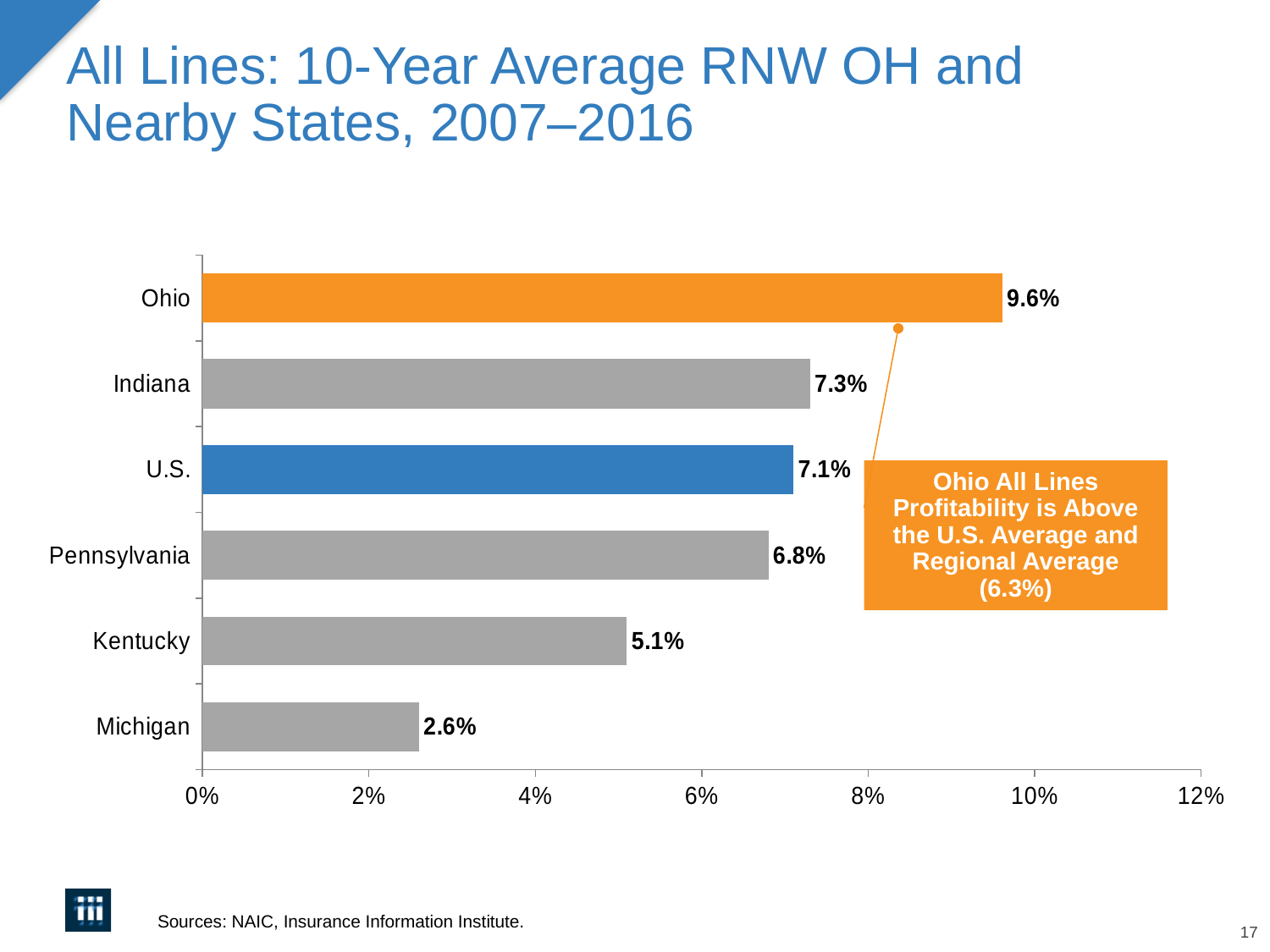
According to the callout box, what is the Regional Average? 6.3% Which state has the highest 10-year average RNW on the chart? Ohio How many categories (bars) are shown on the chart? 6 What is the difference between Ohio's value and the U.S. value? 2.5% Is the value for Michigan greater or less than 4%? less What is the 10-year average RNW for Ohio? 9.6% Which is larger, the value for Pennsylvania or the value for Kentucky? Pennsylvania Which state has the lowest 10-year average RNW on the chart? Michigan What is the 10-year average RNW for Kentucky? 5.1% What kind of chart is shown on the slide? Bar chart What is the difference between Indiana's and Michigan's values? 4.7% What is the value shown for the U.S.? 7.1%